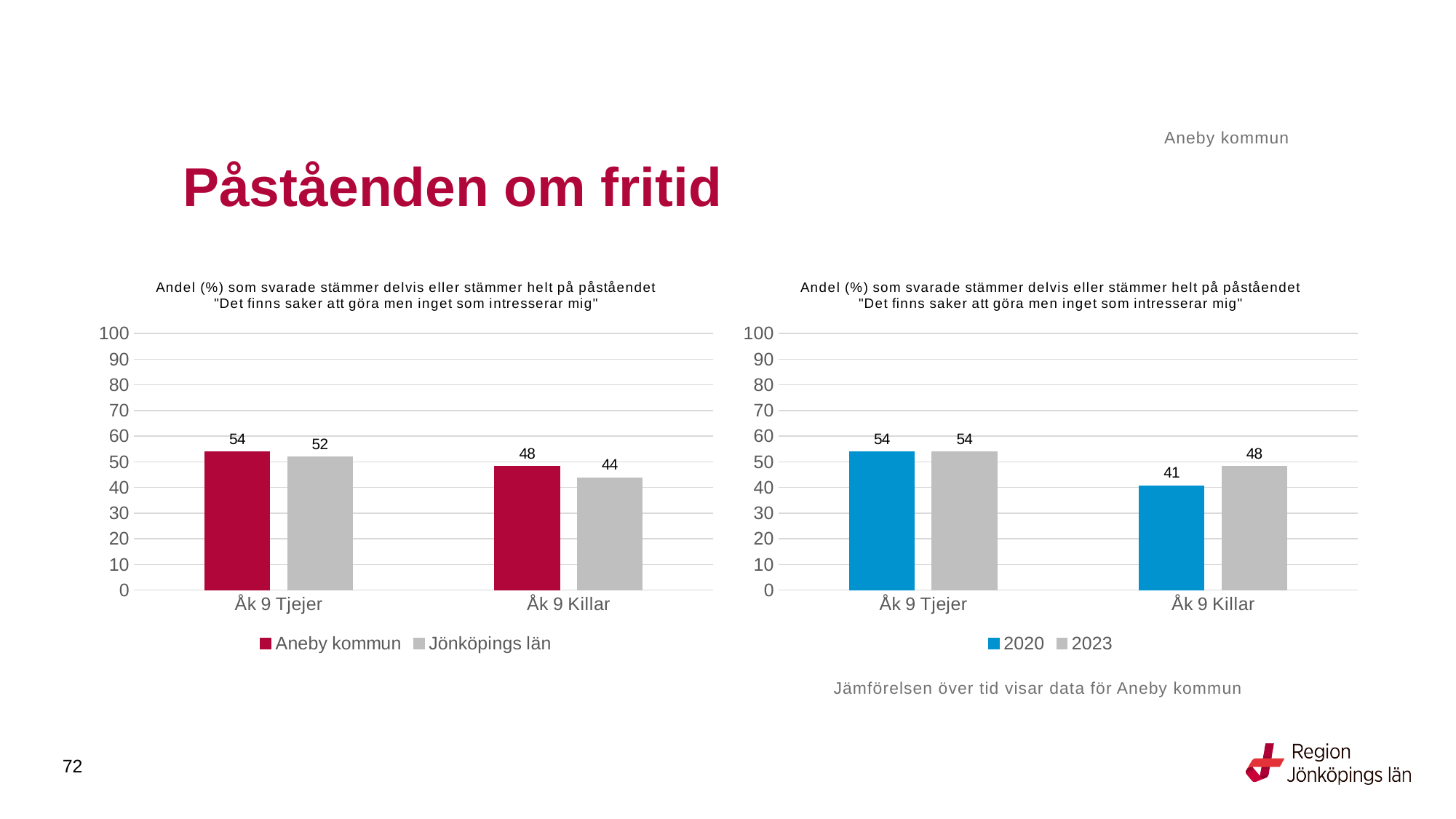
In the right chart, which series has the lowest value shown? 2020 In the right chart, what is the value for 2023 for Åk 9 Tjejer? 54 In the left chart, what is the difference between Aneby kommun and Jönköpings län for Åk 9 Killar? 4 How many series does the legend of the right chart list? 2 In the right chart, what is the difference between 2023 and 2020 for Åk 9 Killar? 7 In the left chart, which is larger for Åk 9 Tjejer: Aneby kommun or Jönköpings län? Aneby kommun In the left chart, what is the value for Aneby kommun for Åk 9 Tjejer? 54 What kind of chart is the left chart? bar chart How many categories are shown on the x axis of the right chart? 2 In the right chart, what is the value for 2020 for Åk 9 Killar? 41 In the left chart, what is the value for Jönköpings län for Åk 9 Killar? 44 In the left chart, is the value for Jönköpings län for Åk 9 Killar greater or less than 50? less